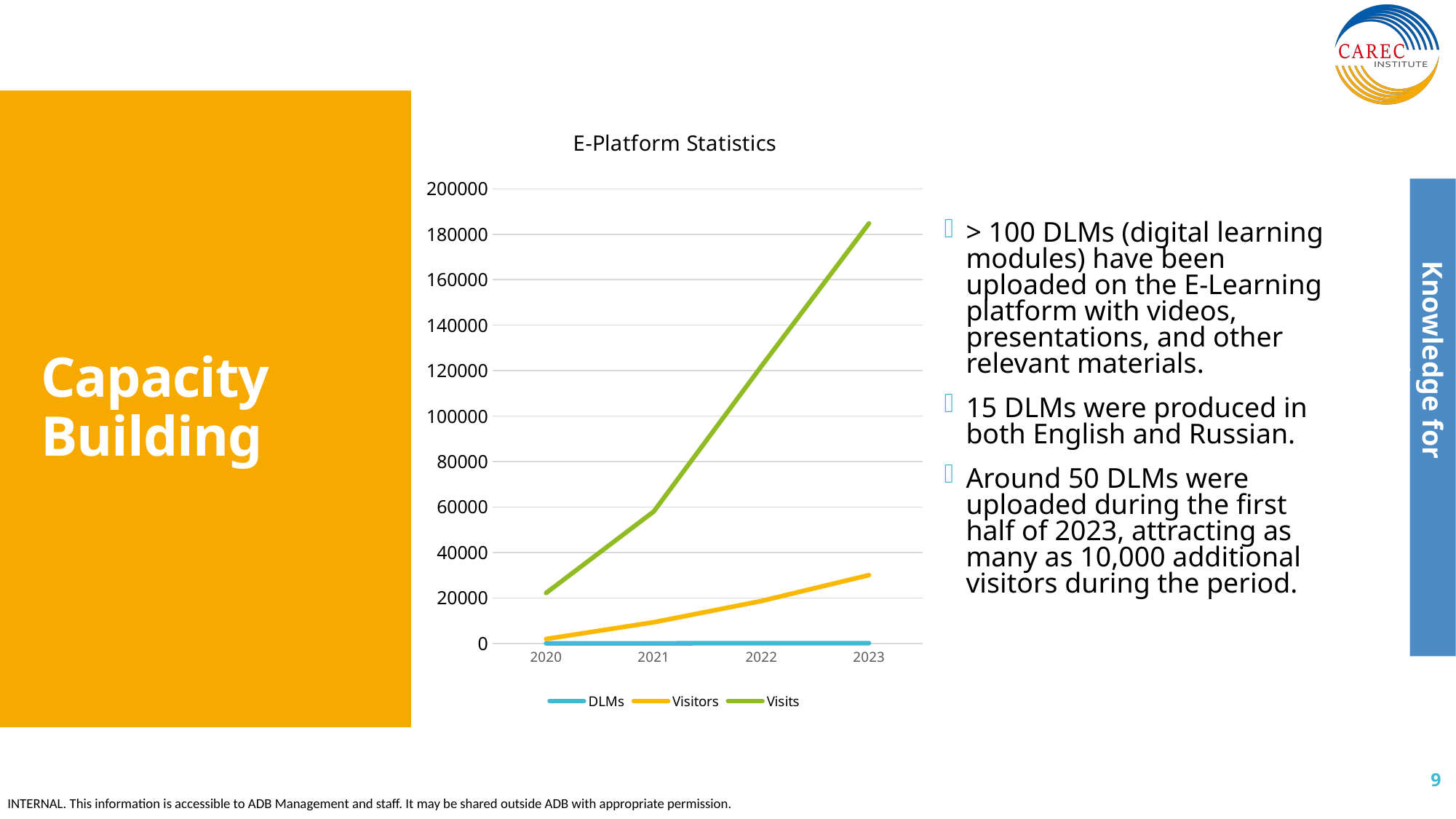
Which series are listed in the chart's legend? DLMs, Visitors, Visits What is the title of the chart? E-Platform Statistics Does the Visitors line rise or fall from 2020 to 2023? Rise Is the value for Visits in 2021 greater or less than 80000? less How many series does the chart's legend list? 3 How many years are shown along the x axis of the chart? 4 Which series has the highest value in 2023? Visits Is the value for Visitors in 2023 greater or less than 40000? less Does the Visits line rise or fall from 2020 to 2023? Rise In 2022, which is larger: the value for Visits or the value for Visitors? Visits Is the value for Visits in 2023 greater or less than 160000? greater What kind of chart is shown on the slide? Line chart